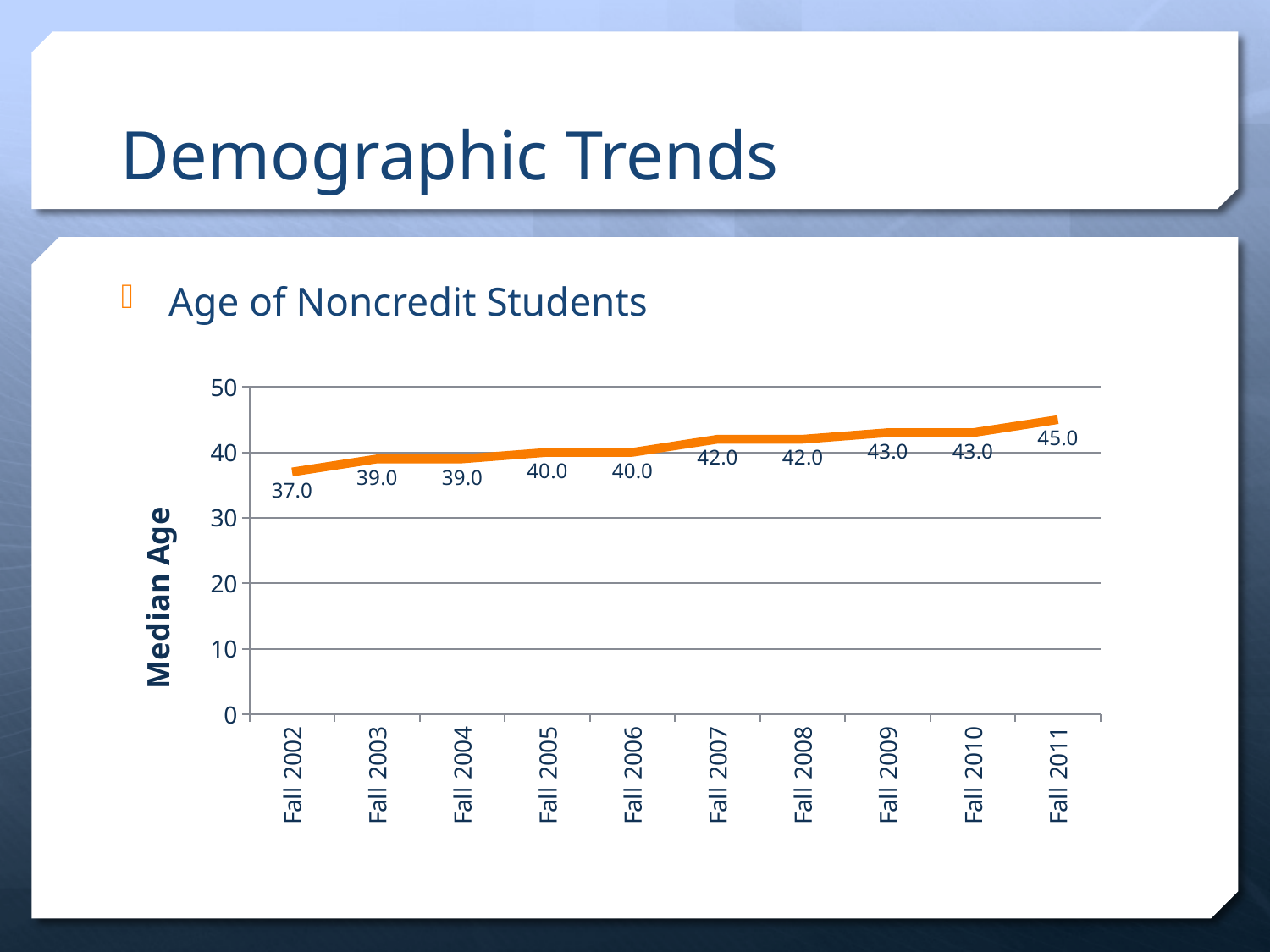
What is the median age of noncredit students in Fall 2007? 42.0 What kind of chart is used to show the age of noncredit students? line chart Which term has the highest median age of noncredit students? Fall 2011 Is the median age of noncredit students higher in Fall 2010 or in Fall 2004? Fall 2010 How many terms are plotted on the chart? 10 Is the median age of noncredit students in Fall 2002 greater or less than 40? less What is the median age of noncredit students in Fall 2002? 37.0 What is the difference in median age between Fall 2009 and Fall 2006? 3.0 Does the median age of noncredit students generally rise or fall from Fall 2002 to Fall 2011? rise Which term has the lowest median age of noncredit students? Fall 2002 What is the median age of noncredit students in Fall 2011? 45.0 By how much did the median age of noncredit students increase from Fall 2002 to Fall 2011? 8.0